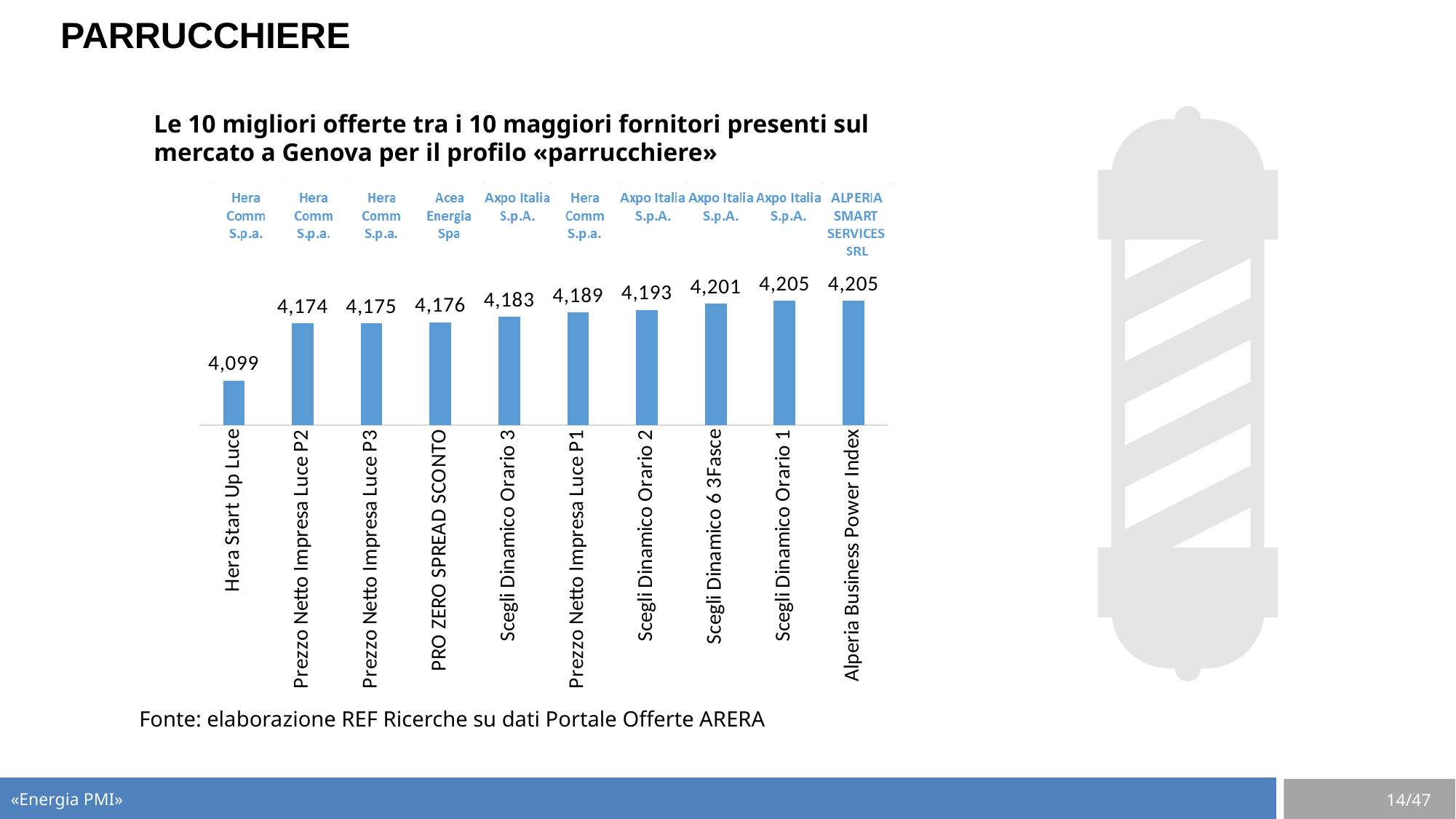
Do the values rise or fall from left to right across the chart? rise What is the value for Hera Start Up Luce? 4,099 Which is larger, the value for Prezzo Netto Impresa Luce P2 or the value for Scegli Dinamico Orario 2? Scegli Dinamico Orario 2 What is the value for PRO ZERO SPREAD SCONTO? 4,176 Which supplier is listed above the bar for PRO ZERO SPREAD SCONTO? Acea Energia Spa Which offer has the lowest value in the chart? Hera Start Up Luce What is the difference between the value for Scegli Dinamico Orario 1 and the value for Hera Start Up Luce? 0,106 What is the value for Scegli Dinamico 6 3Fasce? 4,201 How many offers (bars) are shown in the chart? 10 What is the value for Scegli Dinamico Orario 3? 4,183 What type of chart is shown on the slide? bar chart What is the value for Alperia Business Power Index? 4,205